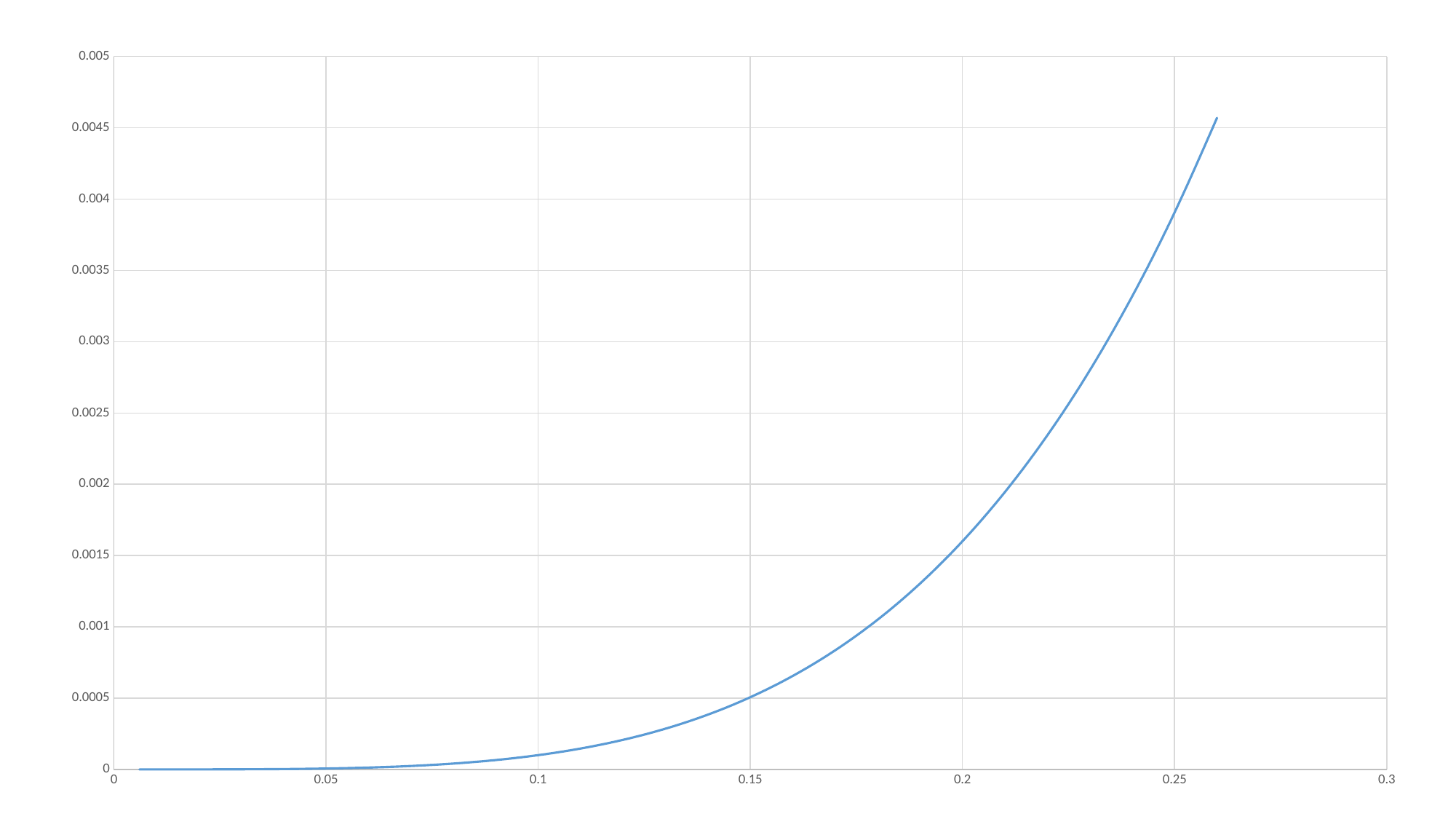
Is the value of the curve at x = 0.25 greater or less than 0.0035? greater How many lines are plotted on the chart? 1 Which is larger, the value of the curve at x = 0.25 or at x = 0.2? x = 0.25 Is the value of the curve at x = 0.2 greater or less than 0.001? greater Is the value of the curve at x = 0.1 greater or less than 0.0005? less What is the highest tick label shown on the y axis? 0.005 What is the highest tick label shown on the x axis? 0.3 Does the curve reach its highest value at its left end or its right end? right end What kind of chart is shown on the slide? line chart Do the plotted values rise or fall as x increases from 0 to 0.25? rise